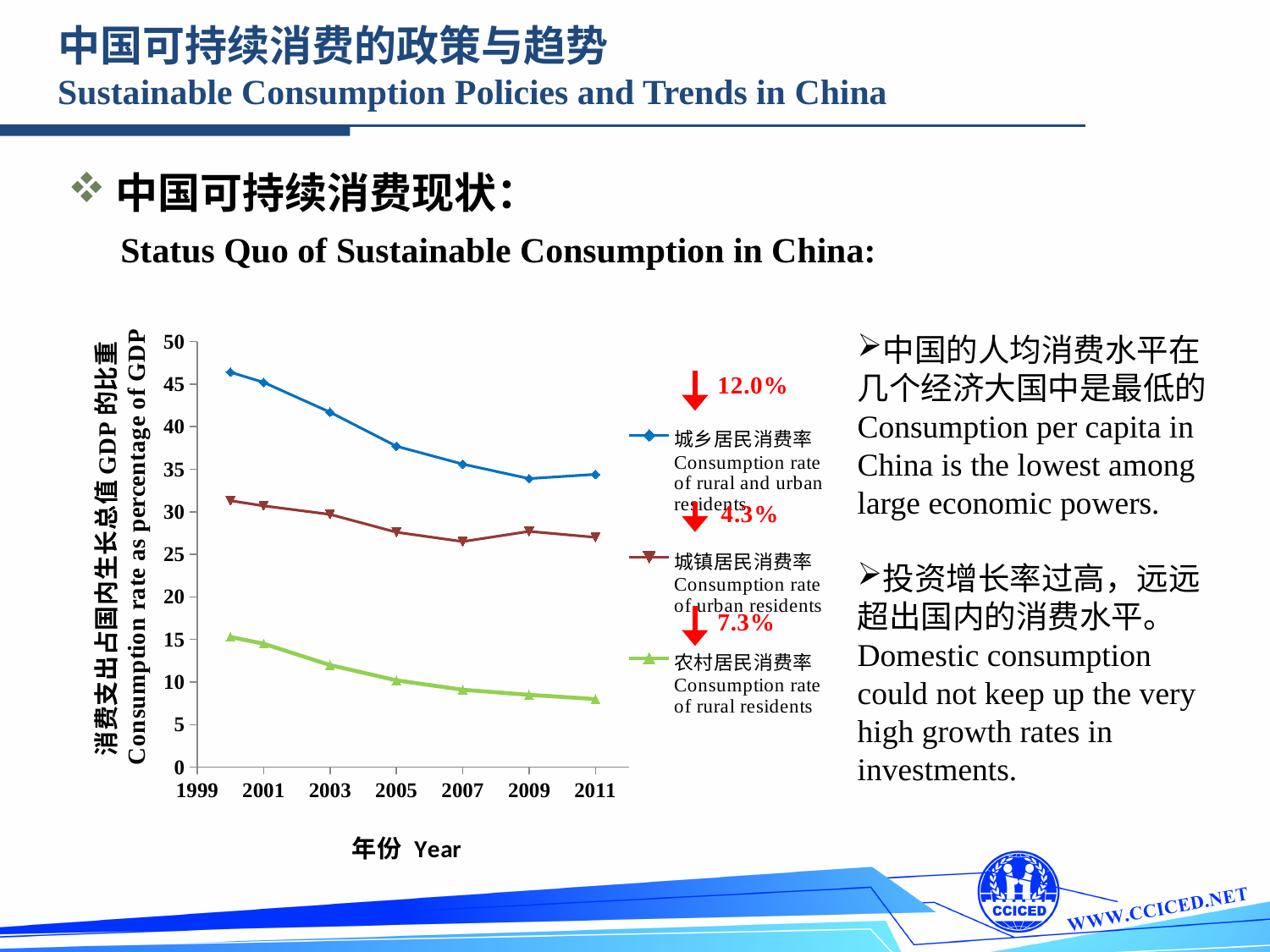
What kind of chart is shown on the slide? line chart Which series has the lowest values throughout the chart? Consumption rate of rural residents What is the label of the x axis? 年份 Year Is the value for the consumption rate of urban residents in 2000 greater or less than 30? greater Is the value for the consumption rate of rural residents in 2011 greater or less than 10? less How many series does the legend list? 3 Which is larger: the consumption rate of urban residents in 2011 or the consumption rate of rural residents in 2011? Consumption rate of urban residents Does the consumption rate of rural and urban residents rise or fall from 2000 to 2011? fall Which series has the highest values throughout the chart? Consumption rate of rural and urban residents Does the consumption rate of rural residents rise or fall along the x axis? fall How many data points are plotted for each series? 7 Is the value for the consumption rate of rural and urban residents in 2000 greater or less than 45? greater